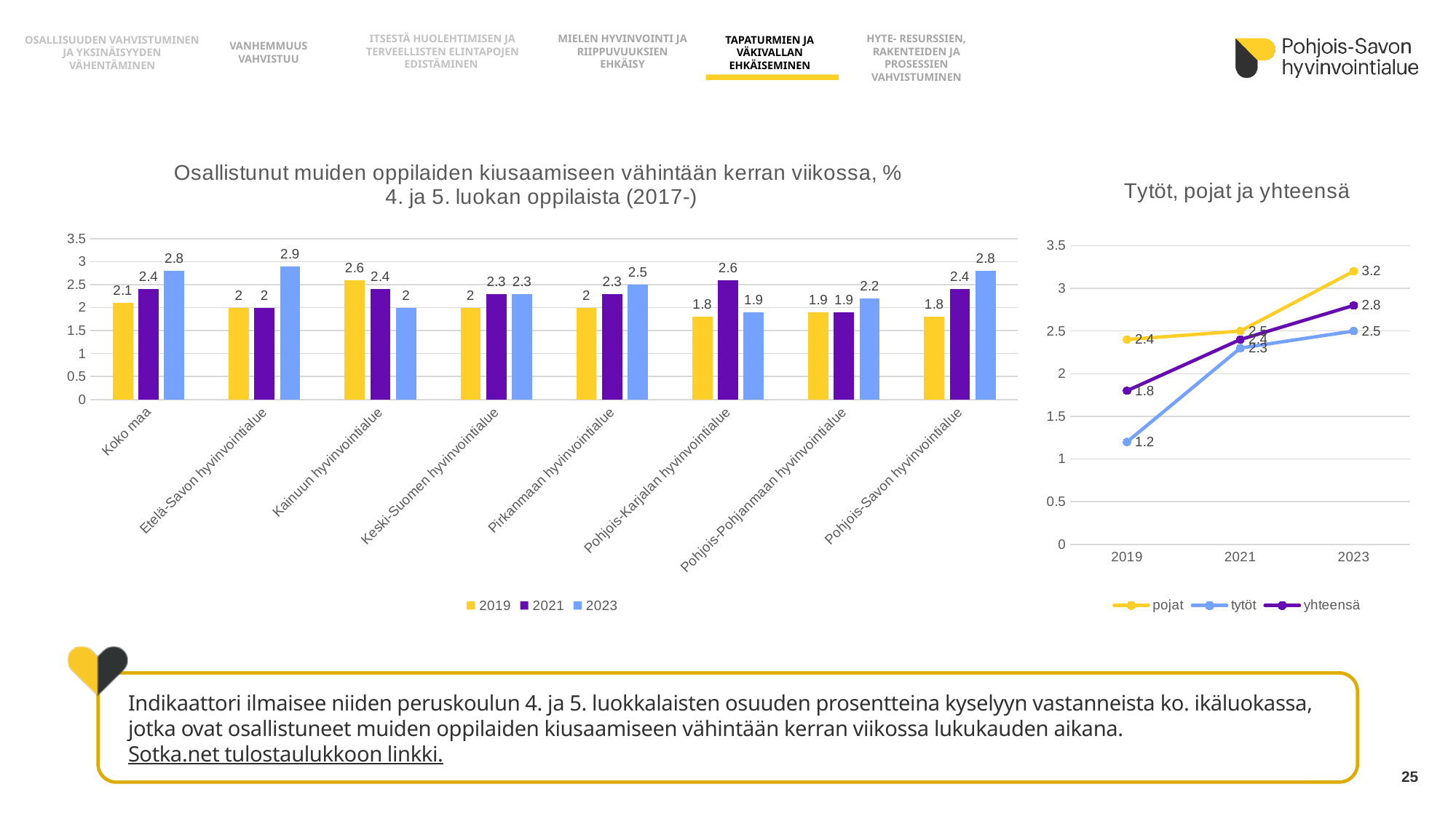
In the bar chart on the left, what is the difference between the 2023 and 2019 values for Pohjois-Savon hyvinvointialue? 1 How many regions are shown on the x axis of the bar chart on the left? 8 In the bar chart on the left, what is the value for Kainuun hyvinvointialue in 2019? 2.6 How many series does the legend of the bar chart on the left list? 3 What kind of chart is the chart titled 'Tytöt, pojat ja yhteensä'? line chart In the bar chart on the left, what is the value for Pohjois-Savon hyvinvointialue in 2023? 2.8 In the bar chart on the left, which is larger for Kainuun hyvinvointialue: the 2019 value or the 2023 value? 2019 In the chart titled 'Tytöt, pojat ja yhteensä', what is the value for tytöt in 2019? 1.2 In the bar chart on the left, which region has the highest value for 2023? Etelä-Savon hyvinvointialue In the chart titled 'Tytöt, pojat ja yhteensä', what is the difference between pojat and tytöt in 2023? 0.7 In the chart titled 'Tytöt, pojat ja yhteensä', does the pojat series rise or fall from 2019 to 2023? rise In the bar chart on the left, which region has the highest value for 2021? Pohjois-Karjalan hyvinvointialue